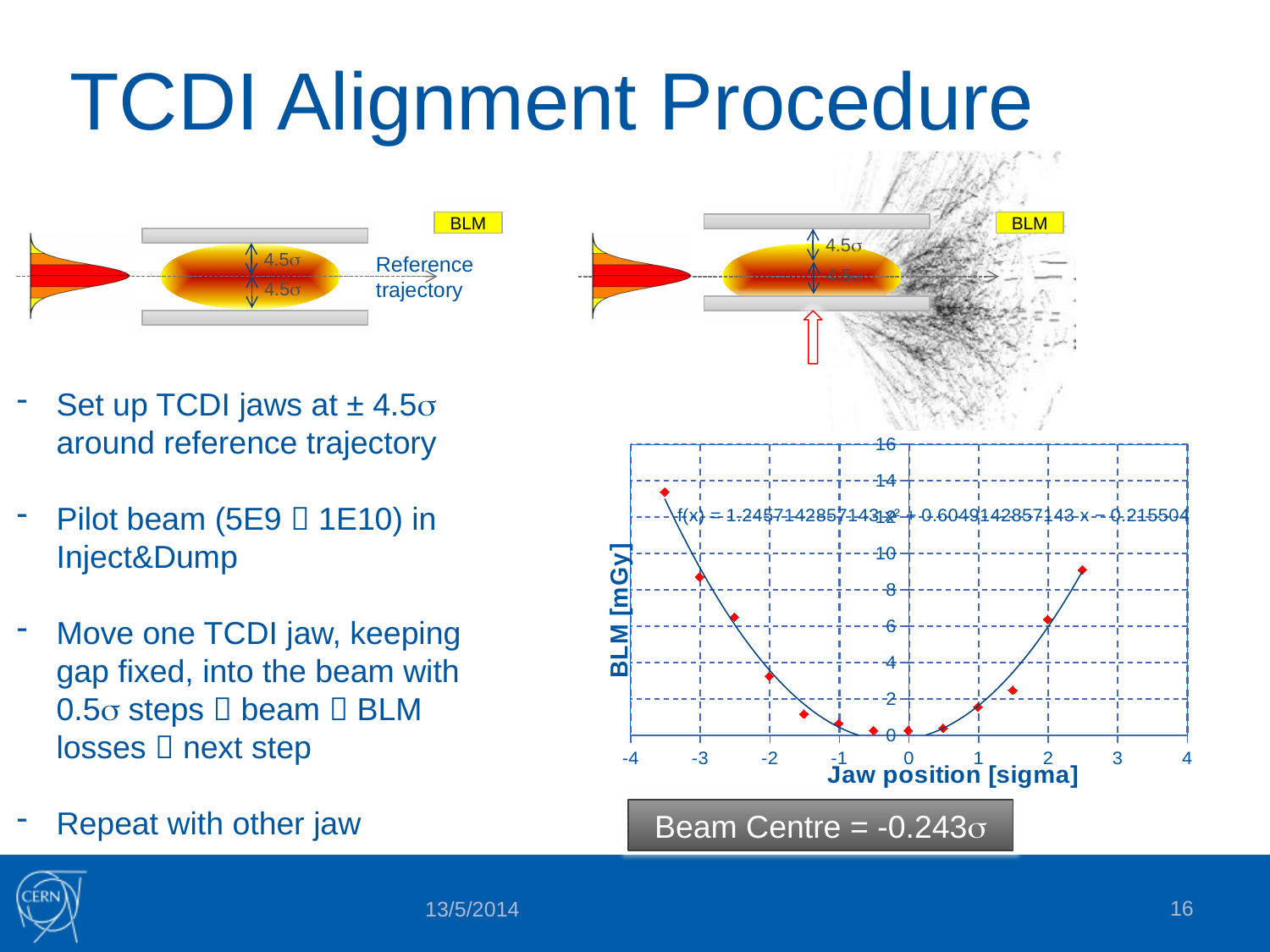
Is the BLM value at jaw position 1 greater or less than 4? less Which has the larger BLM value: jaw position -3 or jaw position 2? -3 At which jaw position is the BLM value highest? -3.5 What kind of chart is shown on the slide? scatter chart Is the BLM value at jaw position 2.5 greater or less than 8? greater Which has the larger BLM value: jaw position -3.5 or jaw position 2.5? -3.5 Do the BLM values rise or fall as the jaw position goes from -3.5 to 0? fall What is the title of the y axis of the chart? BLM [mGy] How many data points are plotted on the chart? 13 Is the BLM value at jaw position -3 greater or less than 10? less What beam centre value is stated below the chart? -0.243σ